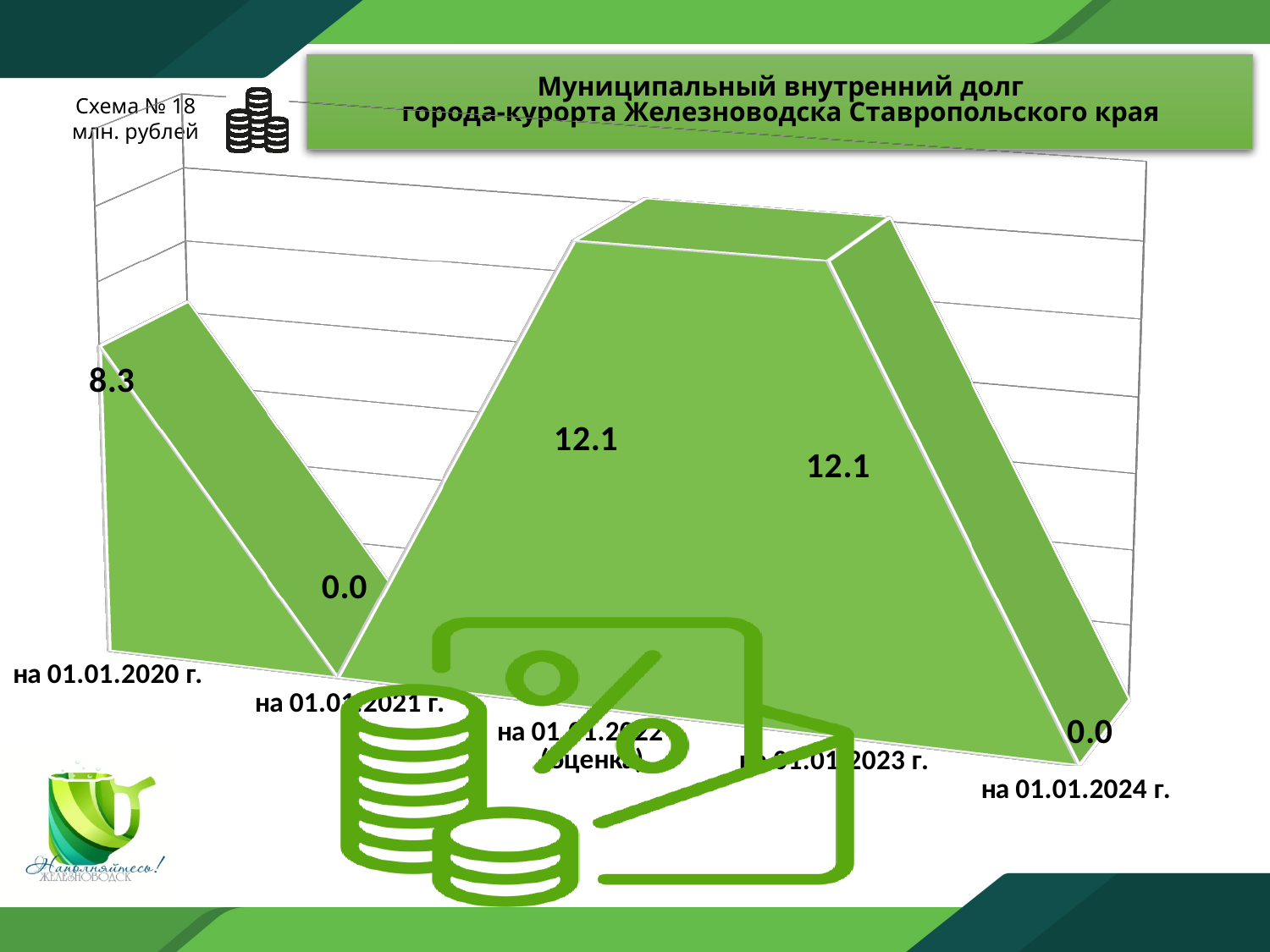
Does the value rise or fall from 01.01.2023 to 01.01.2024? Fall What value is shown for 01.01.2024? 0.0 In what units are the values on the chart expressed? млн. рублей How many dates (data points) are plotted on the chart? 5 What is the difference between the value for 01.01.2023 and the value for 01.01.2020? 3.8 What value is shown for 01.01.2021? 0.0 Which is larger: the value for 01.01.2020 or the value for 01.01.2022? 01.01.2022 Which date has the highest value on the chart? 01.01.2022 and 01.01.2023 (both 12.1) What is the municipal internal debt value shown for 01.01.2020? 8.3 What kind of chart is shown on the slide? Area chart What value is shown for 01.01.2023? 12.1 What is the title of the chart? Муниципальный внутренний долг города-курорта Железноводска Ставропольского края